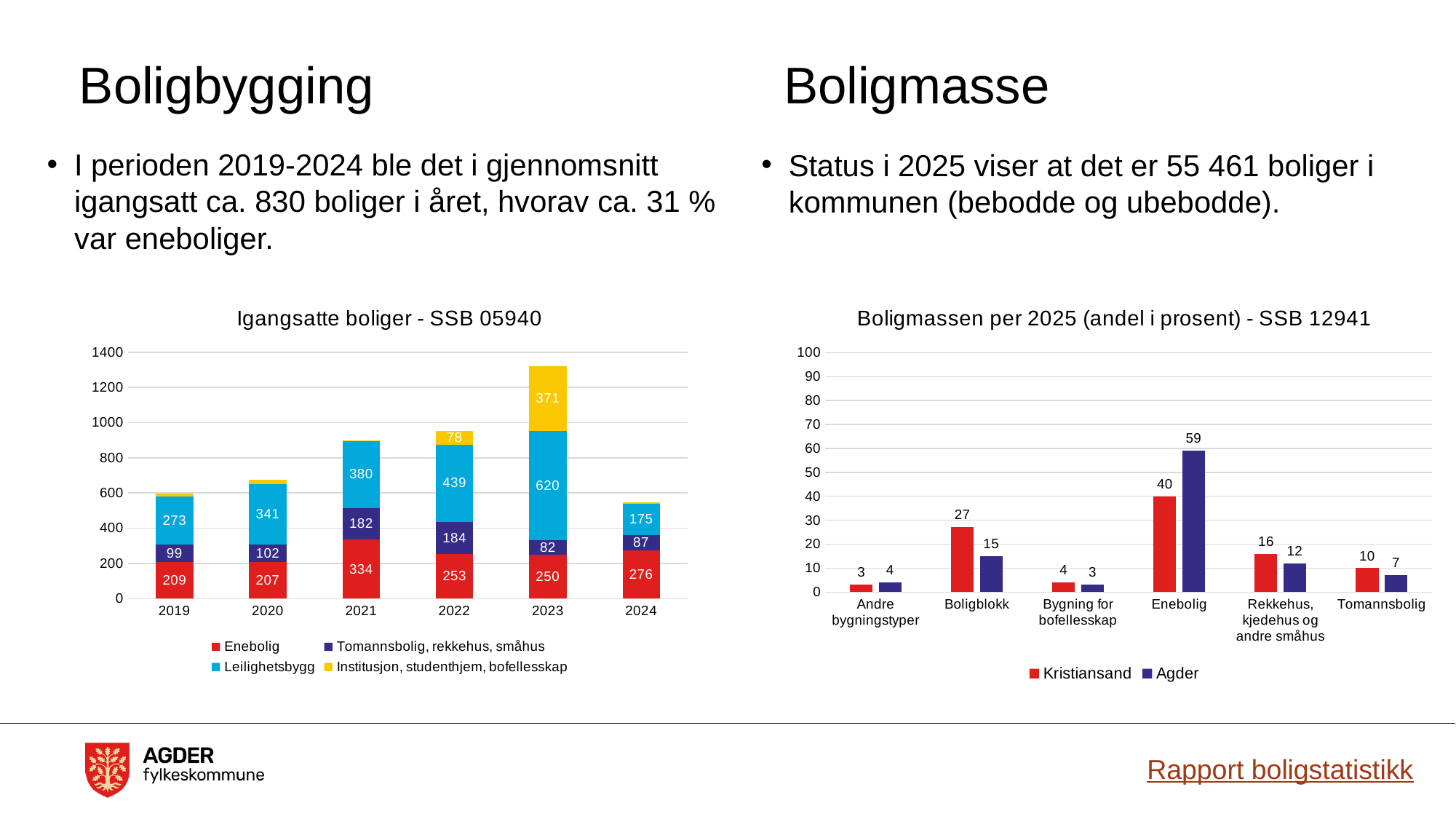
How many categories are shown on the x axis of the chart 'Boligmassen per 2025 (andel i prosent) - SSB 12941'? 6 How many series does the legend of the chart 'Igangsatte boliger - SSB 05940' list? 4 In the chart 'Igangsatte boliger - SSB 05940', which year has the highest Leilighetsbygg value? 2023 In the chart 'Igangsatte boliger - SSB 05940', what is the value for Institusjon, studenthjem, bofellesskap in 2022? 78 In the chart 'Igangsatte boliger - SSB 05940', what is the value for Leilighetsbygg in 2023? 620 In the chart 'Boligmassen per 2025 (andel i prosent) - SSB 12941', what is the value for Agder for Enebolig? 59 In the chart 'Boligmassen per 2025 (andel i prosent) - SSB 12941', which category has the lowest Kristiansand value? Andre bygningstyper In the chart 'Boligmassen per 2025 (andel i prosent) - SSB 12941', which is larger for Boligblokk: Kristiansand or Agder? Kristiansand What kind of chart is 'Boligmassen per 2025 (andel i prosent) - SSB 12941'? Bar chart In the chart 'Igangsatte boliger - SSB 05940', what is the total of the stacked bar for 2023? 1323 In the chart 'Igangsatte boliger - SSB 05940', what is the value for Enebolig in 2021? 334 In the chart 'Igangsatte boliger - SSB 05940', what is the difference between the Enebolig values for 2021 and 2020? 127